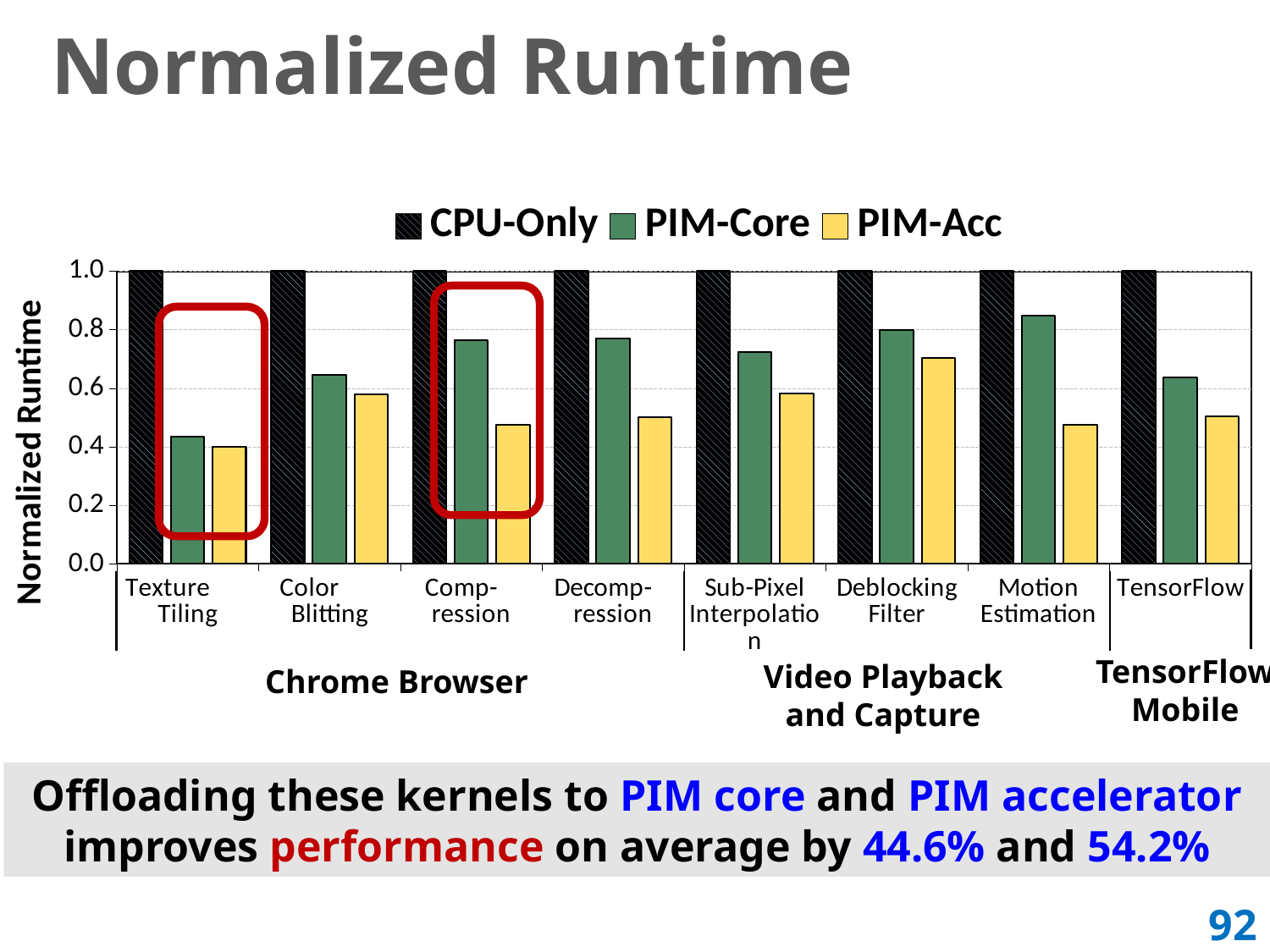
Which kernel has the lowest PIM-Core normalized runtime? Texture Tiling Is the PIM-Acc normalized runtime for Deblocking Filter greater or less than 0.6? greater Which series is shown with yellow bars in the legend? PIM-Acc How many series does the legend list? 3 What is the normalized runtime of CPU-Only for Texture Tiling? 1.0 Which kernel has the highest PIM-Core normalized runtime? Motion Estimation How many kernel categories are plotted along the x axis? 8 Which kernel has the highest PIM-Acc normalized runtime? Deblocking Filter For Compression, which is larger: the PIM-Core or the PIM-Acc normalized runtime? PIM-Core Is the PIM-Core normalized runtime for Texture Tiling greater or less than 0.6? less What is the normalized runtime of CPU-Only for TensorFlow? 1.0 What type of chart is shown on the slide? bar chart